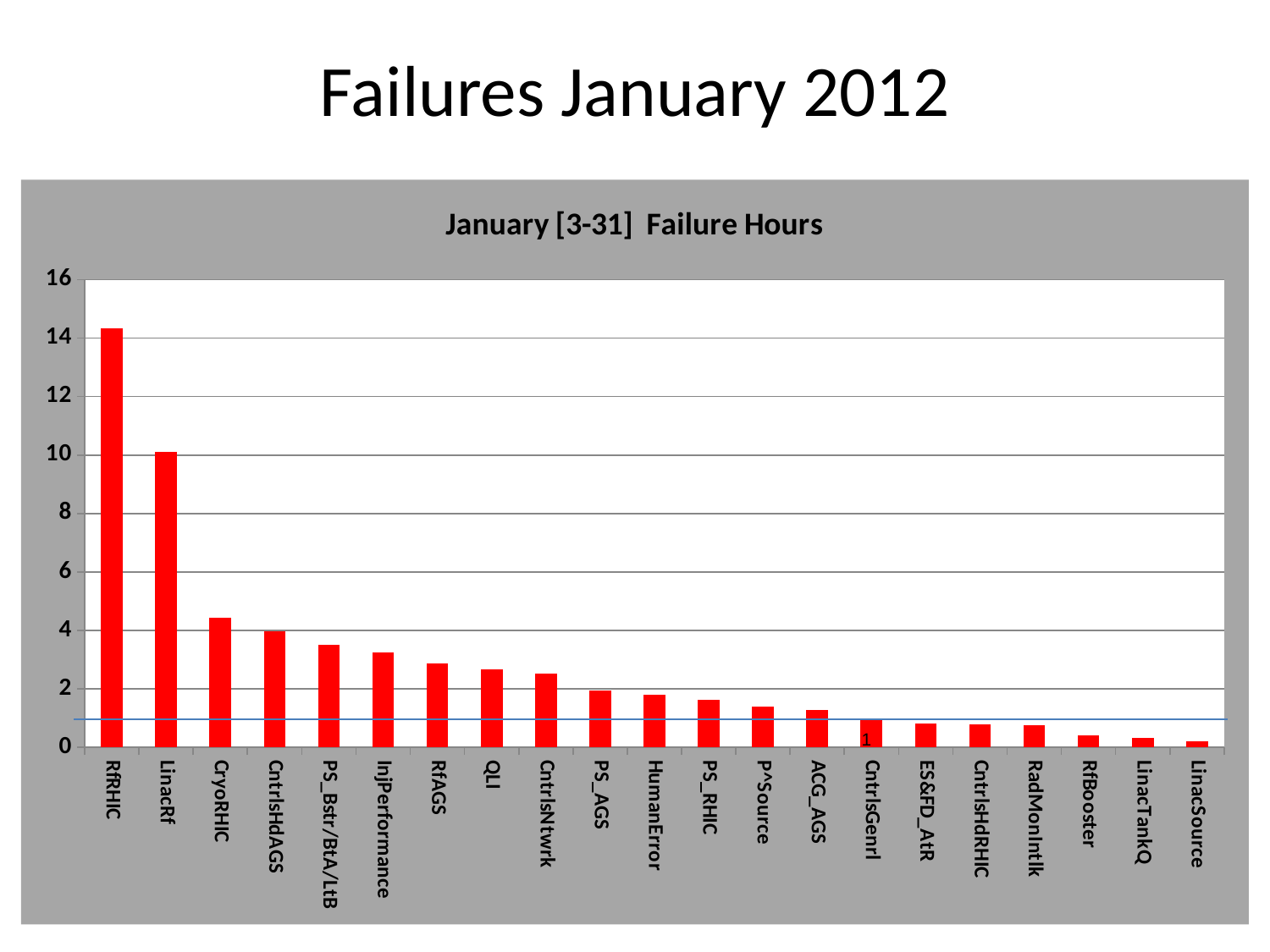
What colour are the bars in the chart? red Is the value for LinacRf greater or less than 8? greater How many categories are plotted on the chart? 21 Which category has the lowest failure hours? LinacSource Is the value for RfRHIC greater or less than 12? greater What kind of chart is shown on the slide? bar chart Is the value for RfBooster greater or less than 2? less Do the values rise or fall moving from left to right along the x axis? fall What is the title of the chart? January [3-31] Failure Hours Which has more failure hours, LinacRf or CryoRHIC? LinacRf Which category has the highest failure hours? RfRHIC